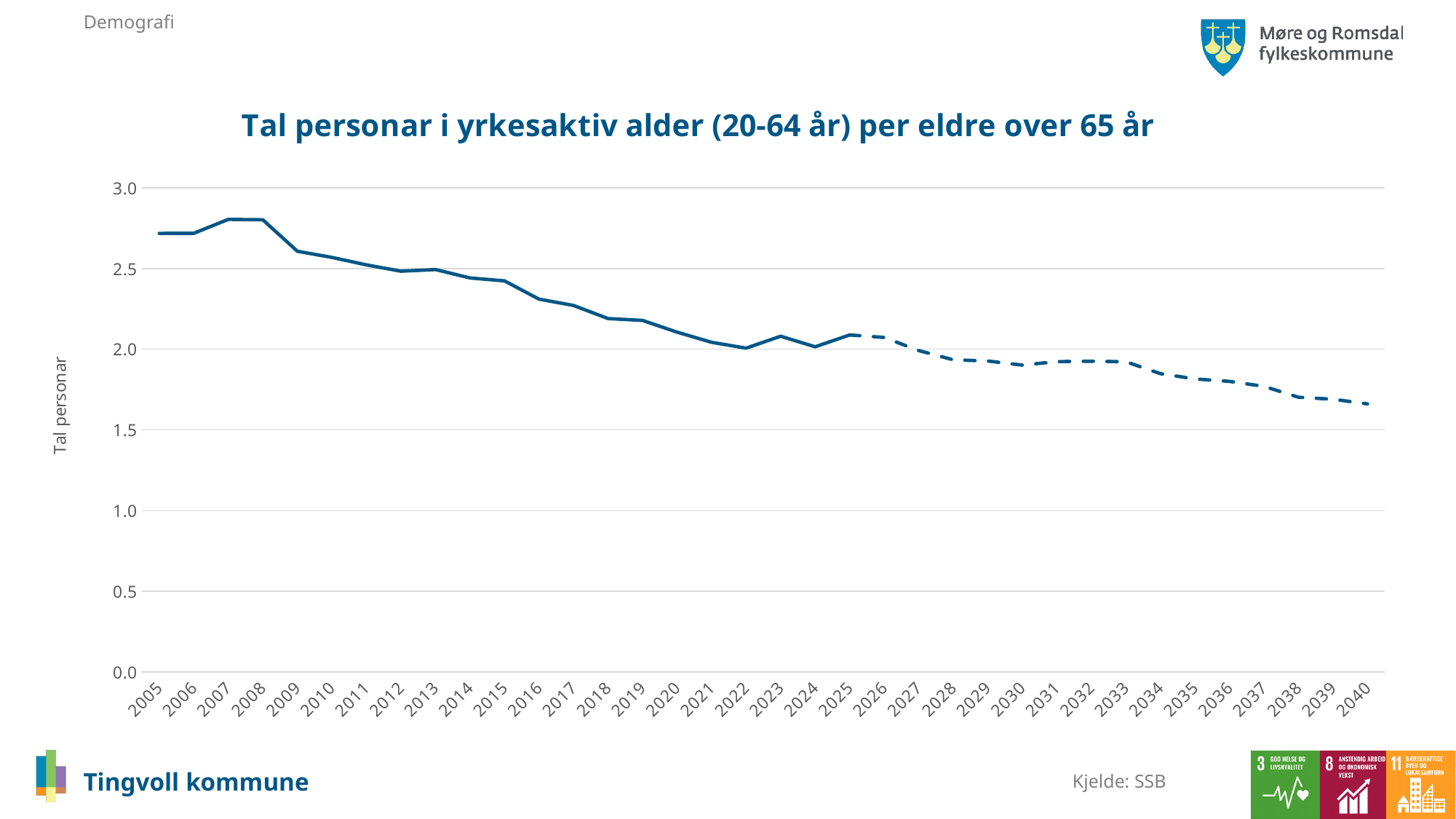
What is the label on the vertical axis? Tal personar Is the value for 2035 greater or less than 2.0? less What is the title of the chart? Tal personar i yrkesaktiv alder (20-64 år) per eldre over 65 år Do the values generally rise or fall from 2005 to 2040? fall Is the value for 2005 greater or less than 2.5? greater Which is larger, the value for 2005 or the value for 2030? 2005 What kind of chart is shown on the slide? line chart How many years are shown along the x axis? 36 Is the value for 2020 greater or less than 2.0? greater Which year has the lowest value on the chart? 2040